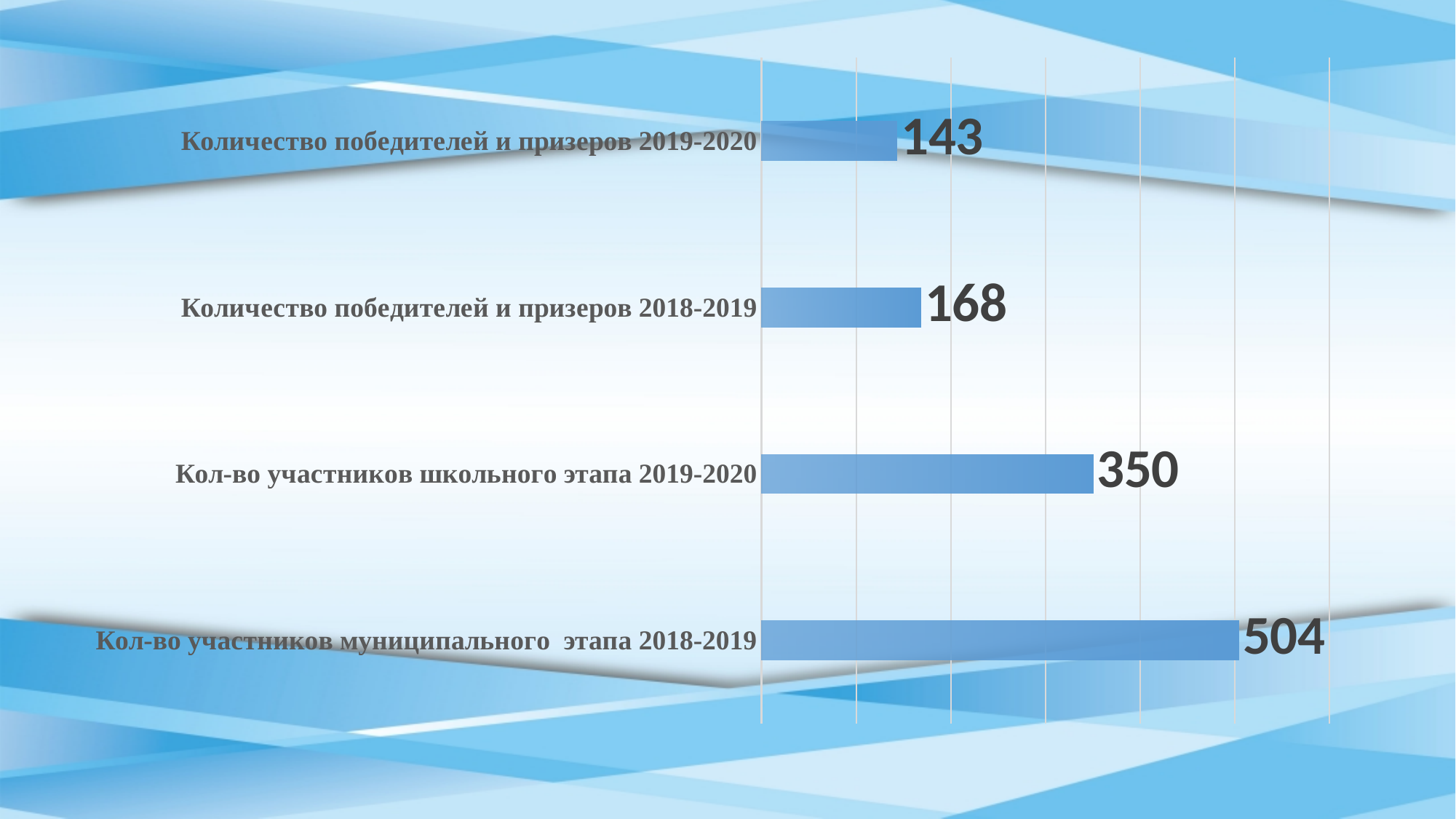
Which category has the lowest value? Количество победителей и призеров 2019-2020 Which is larger: the value for "Количество победителей и призеров 2018-2019" or the value for "Количество победителей и призеров 2019-2020"? Количество победителей и призеров 2018-2019 How many categories are shown in the chart? 4 What kind of chart is shown on the slide? Bar chart What is the value for "Количество победителей и призеров 2018-2019"? 168 What is the difference between the value for "Кол-во участников муниципального этапа 2018-2019" and the value for "Кол-во участников школьного этапа 2019-2020"? 154 What is the value for "Кол-во участников школьного этапа 2019-2020"? 350 What colour are the bars in the chart? Blue What is the difference between the value for "Количество победителей и призеров 2018-2019" and the value for "Количество победителей и призеров 2019-2020"? 25 What is the value for "Количество победителей и призеров 2019-2020"? 143 What is the value for "Кол-во участников муниципального этапа 2018-2019"? 504 Which category has the highest value? Кол-во участников муниципального этапа 2018-2019